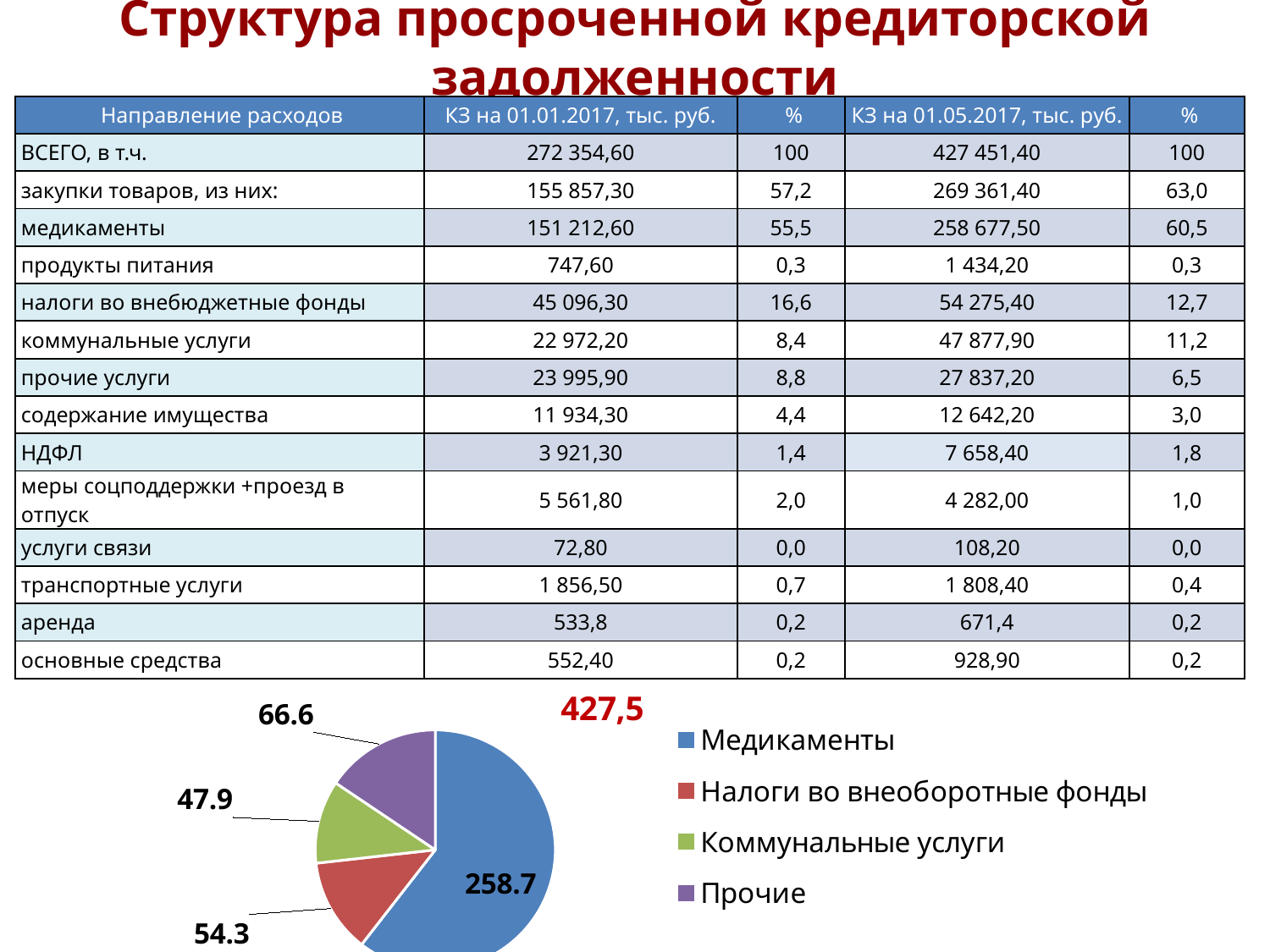
In the pie chart, what is the value for Прочие? 66.6 In the pie chart, which is larger: Прочие or Налоги во внеоборотные фонды? Прочие In the pie chart, what is the value for Медикаменты? 258.7 How many categories does the pie chart legend list? 4 In the pie chart, what is the value for Налоги во внеоборотные фонды? 54.3 What colour is the Медикаменты slice in the pie chart? blue Which category has the largest slice in the pie chart? Медикаменты In the pie chart, what is the difference between the values for Прочие and Коммунальные услуги? 18.7 Which category has the smallest slice in the pie chart? Коммунальные услуги In the pie chart, what is the value for Коммунальные услуги? 47.9 What kind of chart is shown at the bottom of the slide? pie chart In the pie chart, what is the difference between the values for Медикаменты and Налоги во внеоборотные фонды? 204.4